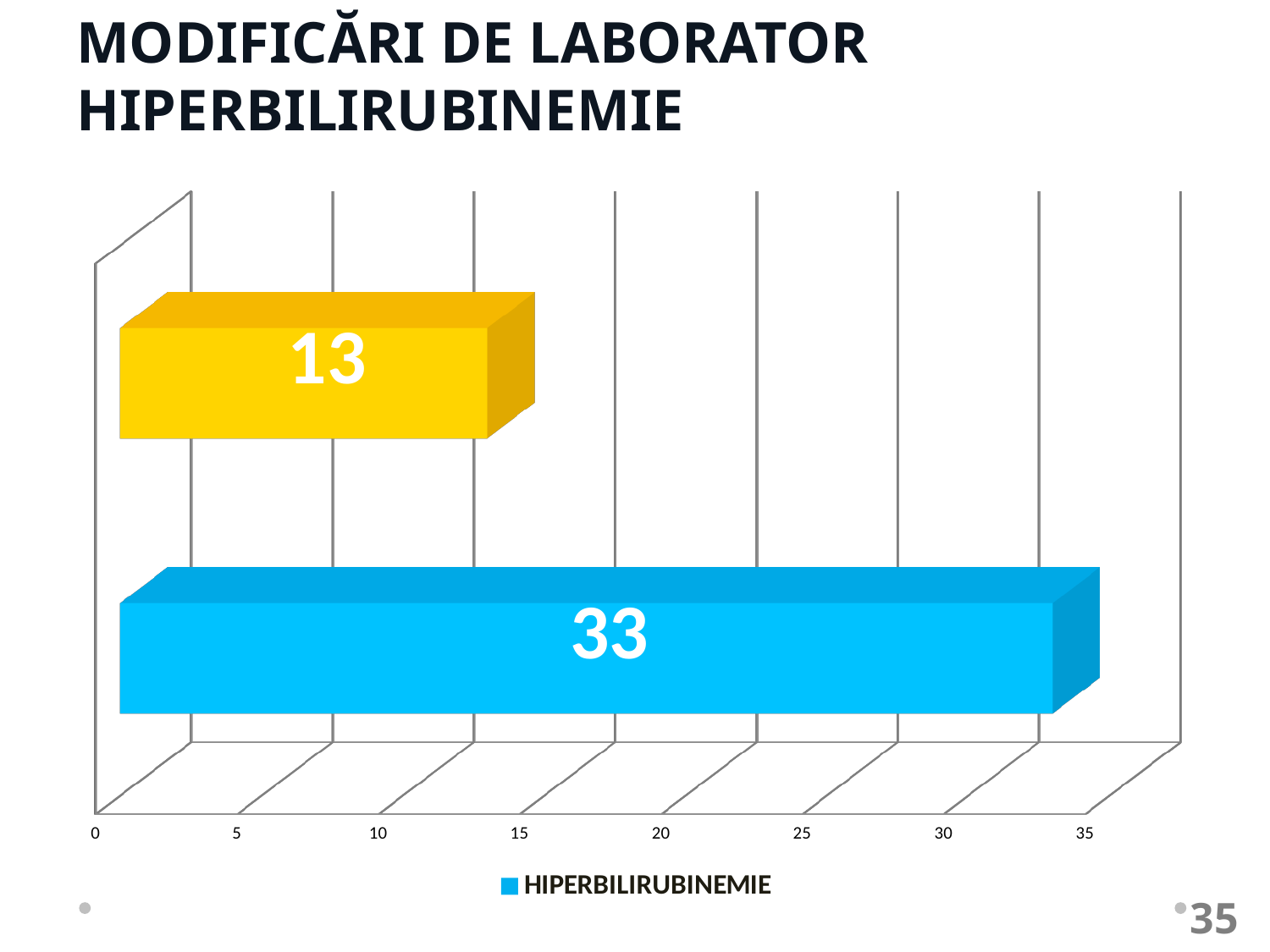
What value is shown on the yellow bar? 13 What value is shown on the blue bar? 33 Is the value of the blue bar greater or less than 30? greater How many series does the legend list? 1 What kind of chart is shown on the slide? bar chart What is the difference between the value of the blue bar and the value of the yellow bar? 20 Is the value of the yellow bar larger or smaller than the value of the blue bar? smaller What series name is shown in the chart legend? HIPERBILIRUBINEMIE Which bar has the lower value, the yellow one or the blue one? the yellow one How many bars are plotted in the chart? 2 Which bar has the higher value, the yellow one or the blue one? the blue one Is the value of the yellow bar greater or less than 15? less